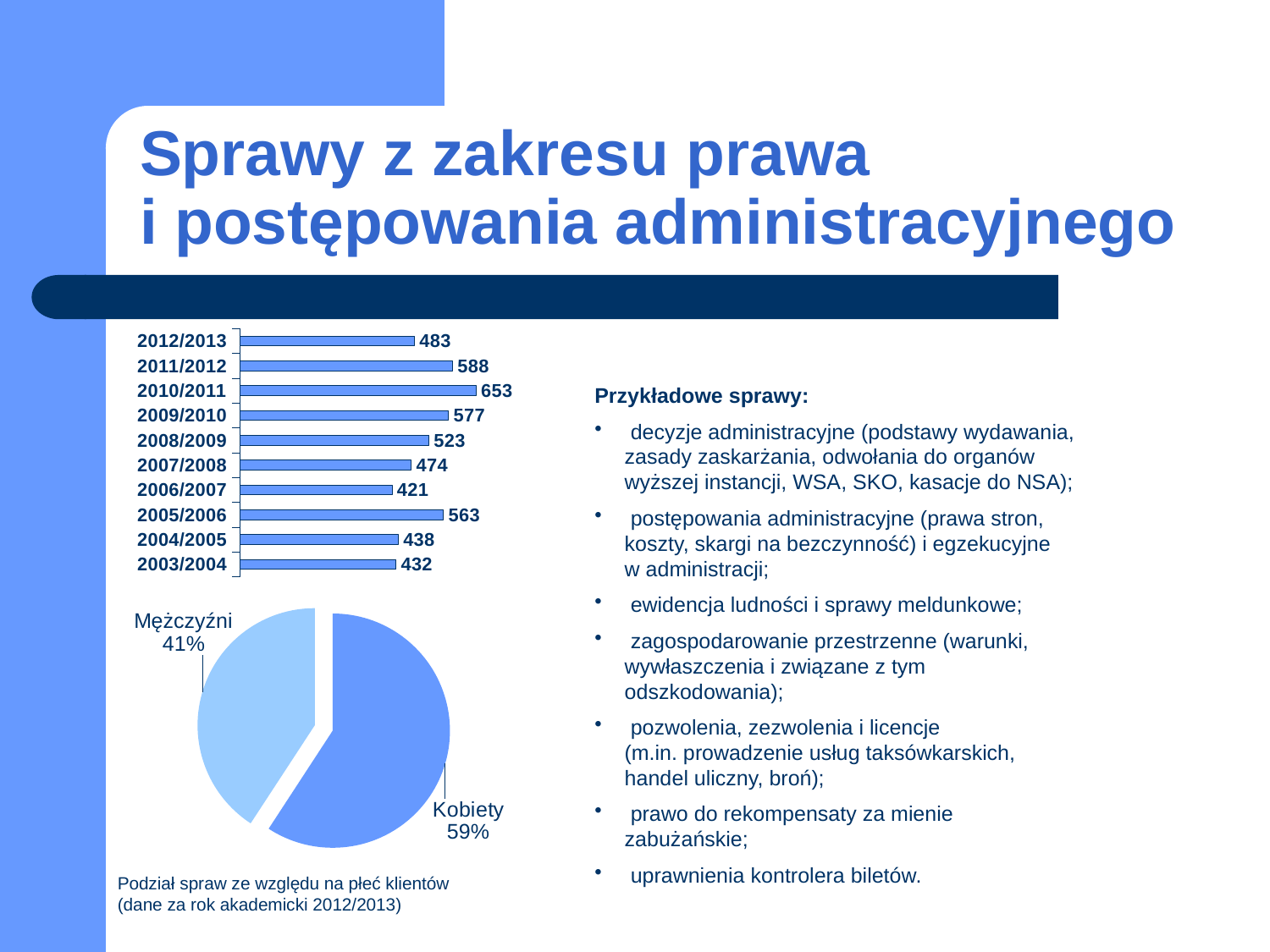
In the bar chart at the top left, what is the difference between the values for 2011/2012 and 2012/2013? 105 In the pie chart at the bottom left, what share is labelled Mężczyźni? 41% What kind of chart is the chart at the bottom left of the slide? pie chart In the bar chart at the top left, which is larger: the value for 2005/2006 or the value for 2008/2009? 2005/2006 What kind of chart is the chart at the top left of the slide? bar chart In the pie chart at the bottom left, what share is labelled Kobiety? 59% In the pie chart at the bottom left, which slice is larger: Kobiety or Mężczyźni? Kobiety How many academic years are shown in the bar chart at the top left? 10 In the bar chart at the top left, what is the value for 2010/2011? 653 In the bar chart at the top left, which academic year has the highest value? 2010/2011 In the bar chart at the top left, what is the value for 2003/2004? 432 In the bar chart at the top left, which academic year has the lowest value? 2006/2007